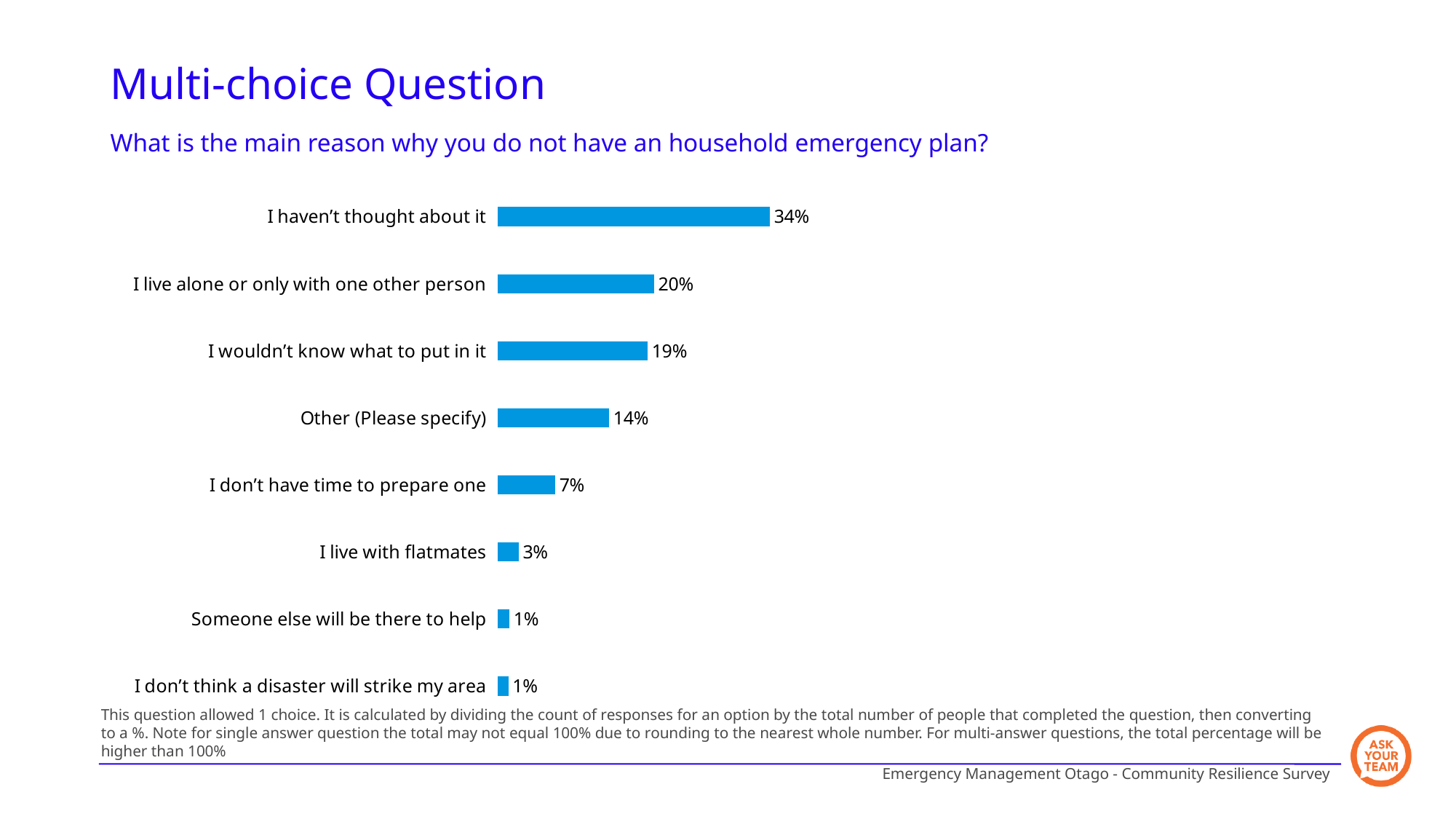
Which reason has the highest percentage in the chart? I haven't thought about it Which two reasons share the lowest value of 1%? Someone else will be there to help; I don't think a disaster will strike my area What colour are the bars in the chart? Blue What is the difference in percentage points between "I haven't thought about it" and "I live alone or only with one other person"? 14 What is the difference in percentage points between "Other (Please specify)" and "I live with flatmates"? 11 What percentage of respondents chose "I haven't thought about it" as the main reason for not having a household emergency plan? 34% How many reasons (categories) are shown in the chart? 8 What survey question does the chart answer? What is the main reason why you do not have an household emergency plan? Which is larger: the value for "I live alone or only with one other person" or the value for "Other (Please specify)"? I live alone or only with one other person What type of chart is shown on the slide? Bar chart What percentage is shown for "I don't have time to prepare one"? 7% What is the value shown for "I wouldn't know what to put in it"? 19%